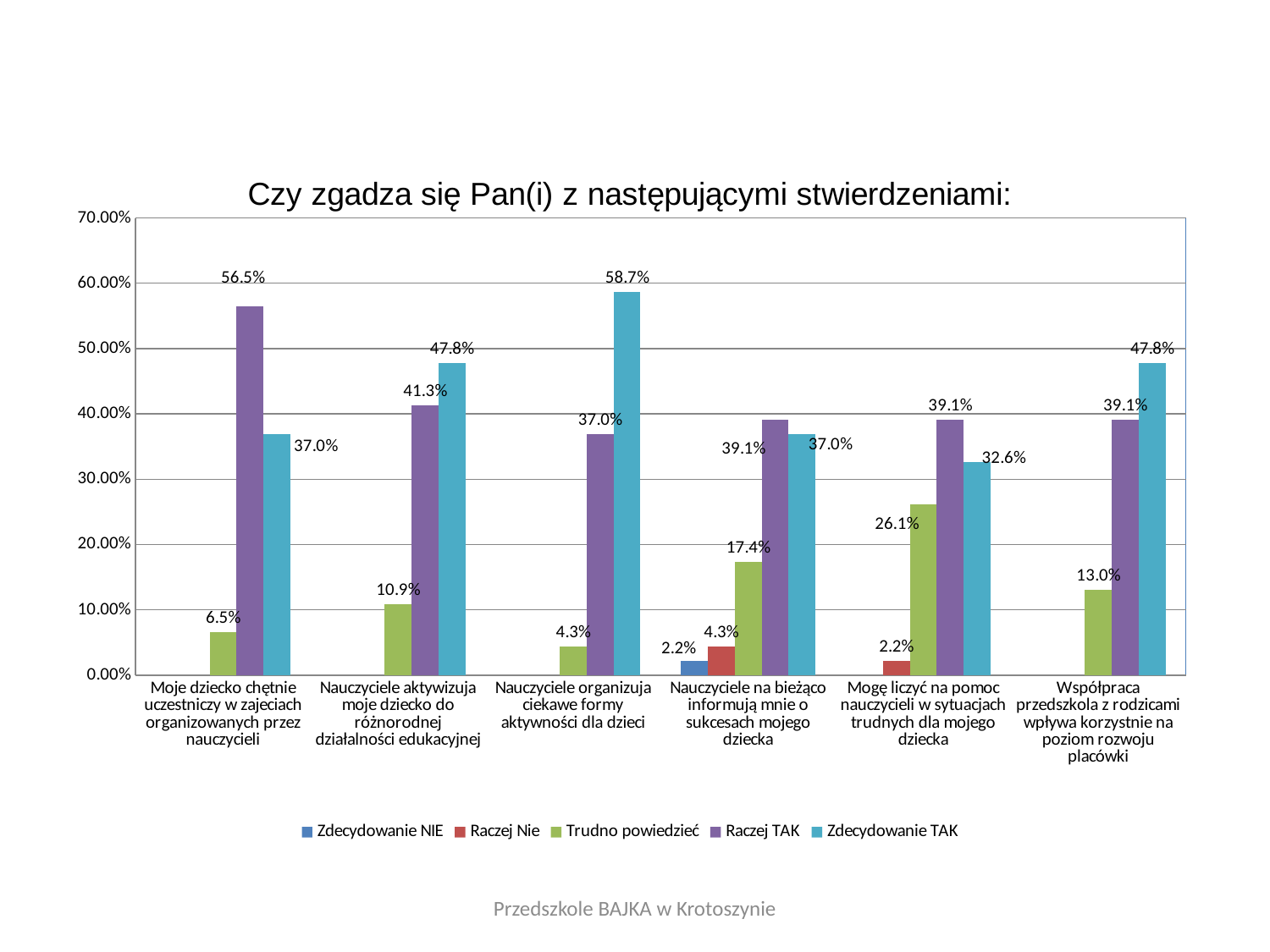
Which statement has the lowest "Trudno powiedzieć" value? Nauczyciele organizują ciekawe formy aktywności dla dzieci For "Współpraca przedszkola z rodzicami wpływa korzystnie na poziom rozwoju placówki", which is larger: "Raczej TAK" or "Zdecydowanie TAK"? Zdecydowanie TAK What is the value of "Zdecydowanie TAK" for "Nauczyciele organizują ciekawe formy aktywności dla dzieci"? 58.7% What is the title of the chart? Czy zgadza się Pan(i) z następującymi stwierdzeniami: What is the value of "Zdecydowanie NIE" for "Nauczyciele na bieżąco informują mnie o sukcesach mojego dziecka"? 2.2% Which statement has the highest "Zdecydowanie TAK" value? Nauczyciele organizują ciekawe formy aktywności dla dzieci What is the value of "Raczej TAK" for "Moje dziecko chętnie uczestniczy w zajęciach organizowanych przez nauczycieli"? 56.5% What is the difference between "Zdecydowanie TAK" and "Raczej TAK" for "Nauczyciele aktywizują moje dziecko do różnorodnej działalności edukacyjnej"? 6.5% How many series does the legend list? 5 What type of chart is shown on the slide? bar chart How many statement categories are shown on the x axis? 6 What is the value of "Trudno powiedzieć" for "Mogę liczyć na pomoc nauczycieli w sytuacjach trudnych dla mojego dziecka"? 26.1%